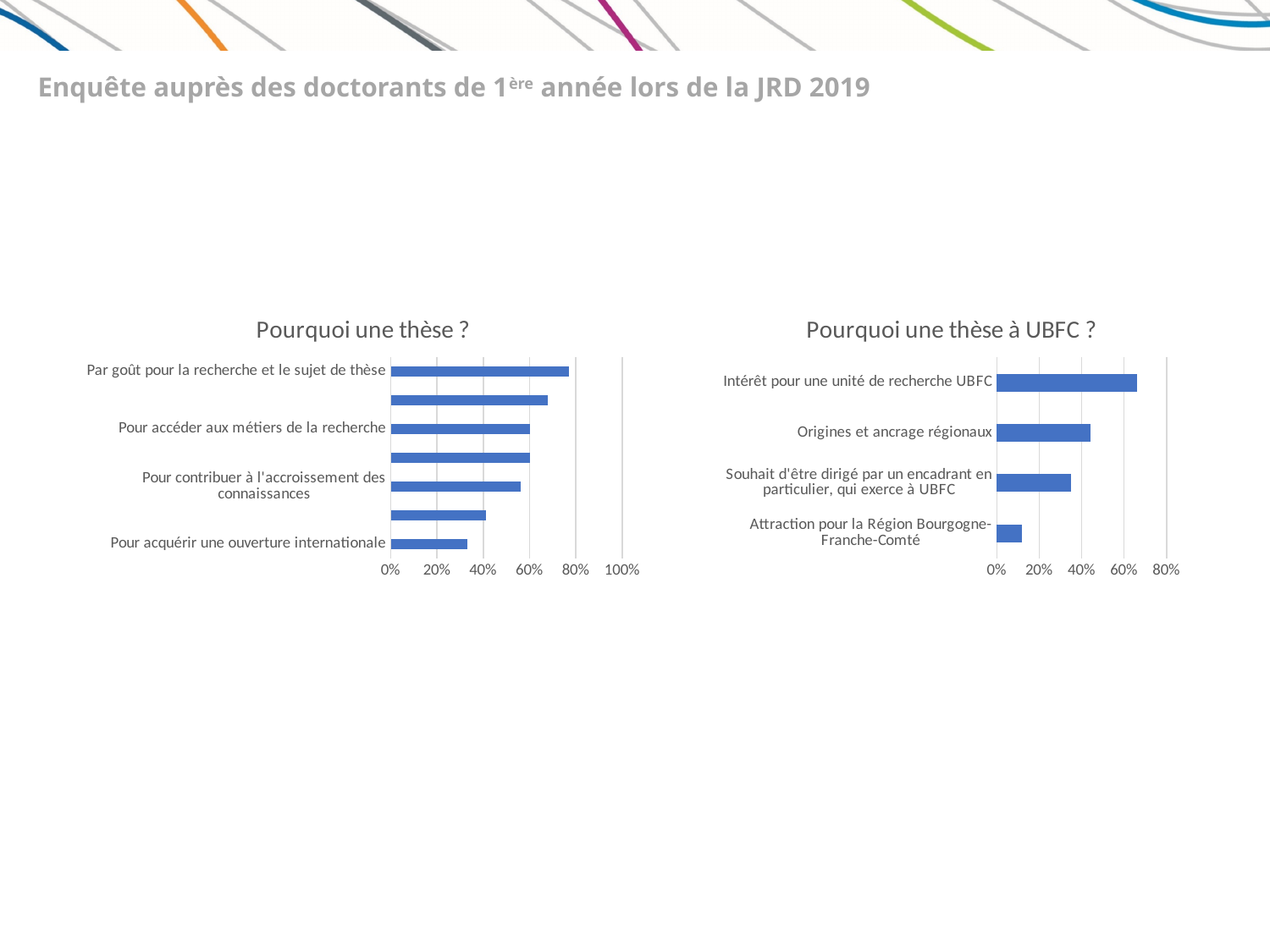
What kind of chart is the chart titled "Pourquoi une thèse ?"? bar chart In the chart titled "Pourquoi une thèse à UBFC ?", is the value for "Attraction pour la Région Bourgogne-Franche-Comté" greater or less than 20%? less In the chart titled "Pourquoi une thèse à UBFC ?", which category has the lowest value? Attraction pour la Région Bourgogne-Franche-Comté In the chart titled "Pourquoi une thèse ?", is the value for "Pour acquérir une ouverture internationale" greater or less than 40%? less In the chart titled "Pourquoi une thèse à UBFC ?", which is larger: "Origines et ancrage régionaux" or "Souhait d'être dirigé par un encadrant en particulier, qui exerce à UBFC"? Origines et ancrage régionaux In the chart titled "Pourquoi une thèse ?", which labelled category has the lowest value? Pour acquérir une ouverture internationale In the chart titled "Pourquoi une thèse à UBFC ?", which category has the highest value? Intérêt pour une unité de recherche UBFC In the chart titled "Pourquoi une thèse ?", which is larger: "Par goût pour la recherche et le sujet de thèse" or "Pour accéder aux métiers de la recherche"? Par goût pour la recherche et le sujet de thèse How many categories are shown in the chart titled "Pourquoi une thèse à UBFC ?"? 4 In the chart titled "Pourquoi une thèse ?", which labelled category has the highest value? Par goût pour la recherche et le sujet de thèse In the chart titled "Pourquoi une thèse à UBFC ?", is the value for "Souhait d'être dirigé par un encadrant en particulier, qui exerce à UBFC" greater or less than 40%? less